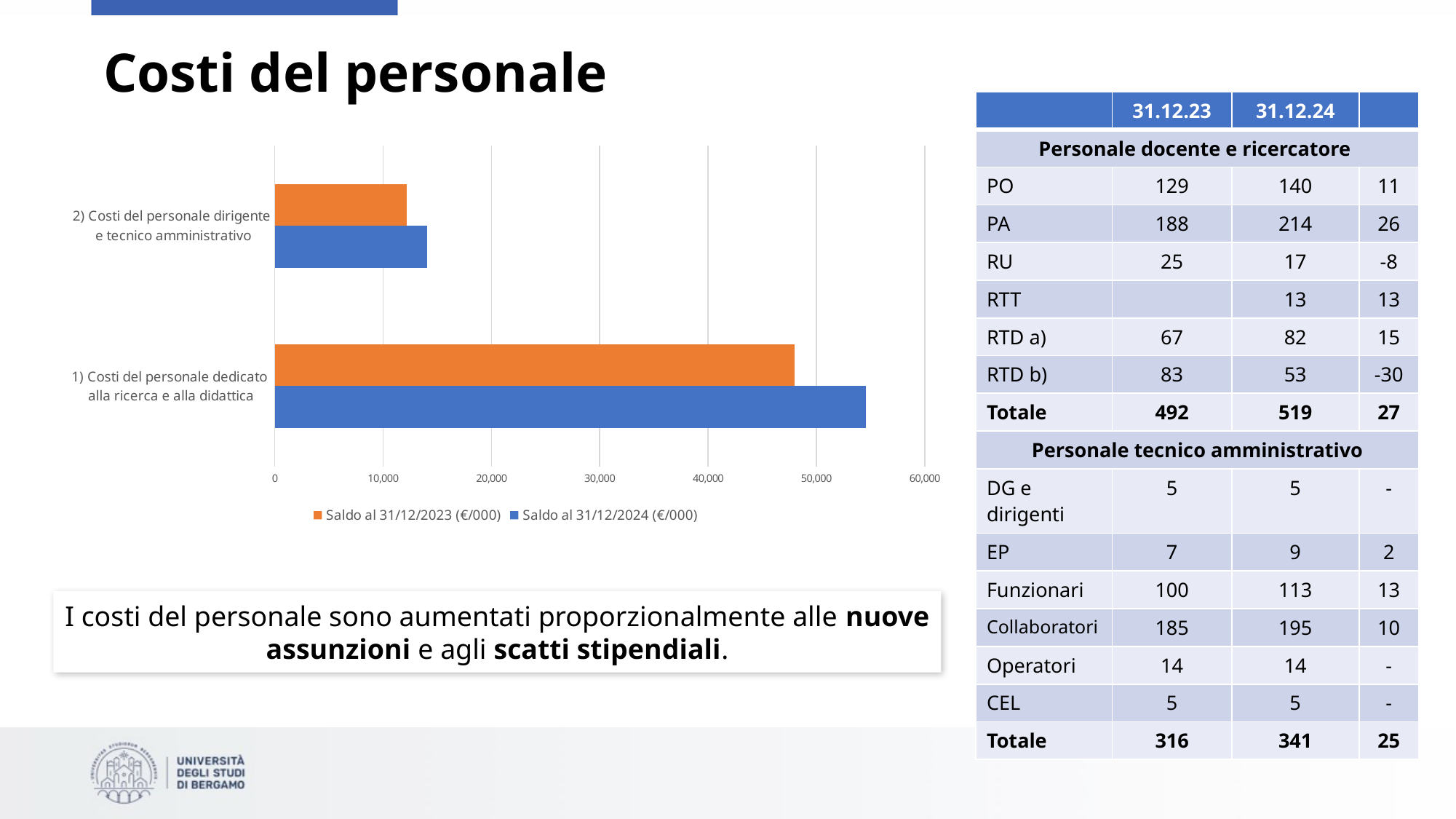
For '1) Costi del personale dedicato alla ricerca e alla didattica', which is larger: Saldo al 31/12/2023 or Saldo al 31/12/2024? Saldo al 31/12/2024 Is the Saldo al 31/12/2023 value for '1) Costi del personale dedicato alla ricerca e alla didattica' greater or less than 50,000? less Which category has the highest value in the bar chart? 1) Costi del personale dedicato alla ricerca e alla didattica How many series does the chart legend list? 2 For '2) Costi del personale dirigente e tecnico amministrativo', which is larger: Saldo al 31/12/2023 or Saldo al 31/12/2024? Saldo al 31/12/2024 How many categories does the bar chart show? 2 Is the Saldo al 31/12/2024 value for '2) Costi del personale dirigente e tecnico amministrativo' greater or less than 20,000? less Which series has the lowest value for '2) Costi del personale dirigente e tecnico amministrativo'? Saldo al 31/12/2023 (€/000) What kind of chart is shown on the slide? bar chart Is the Saldo al 31/12/2023 value for '2) Costi del personale dirigente e tecnico amministrativo' greater or less than 10,000? greater Which colour represents the series 'Saldo al 31/12/2024 (€/000)' in the chart? blue